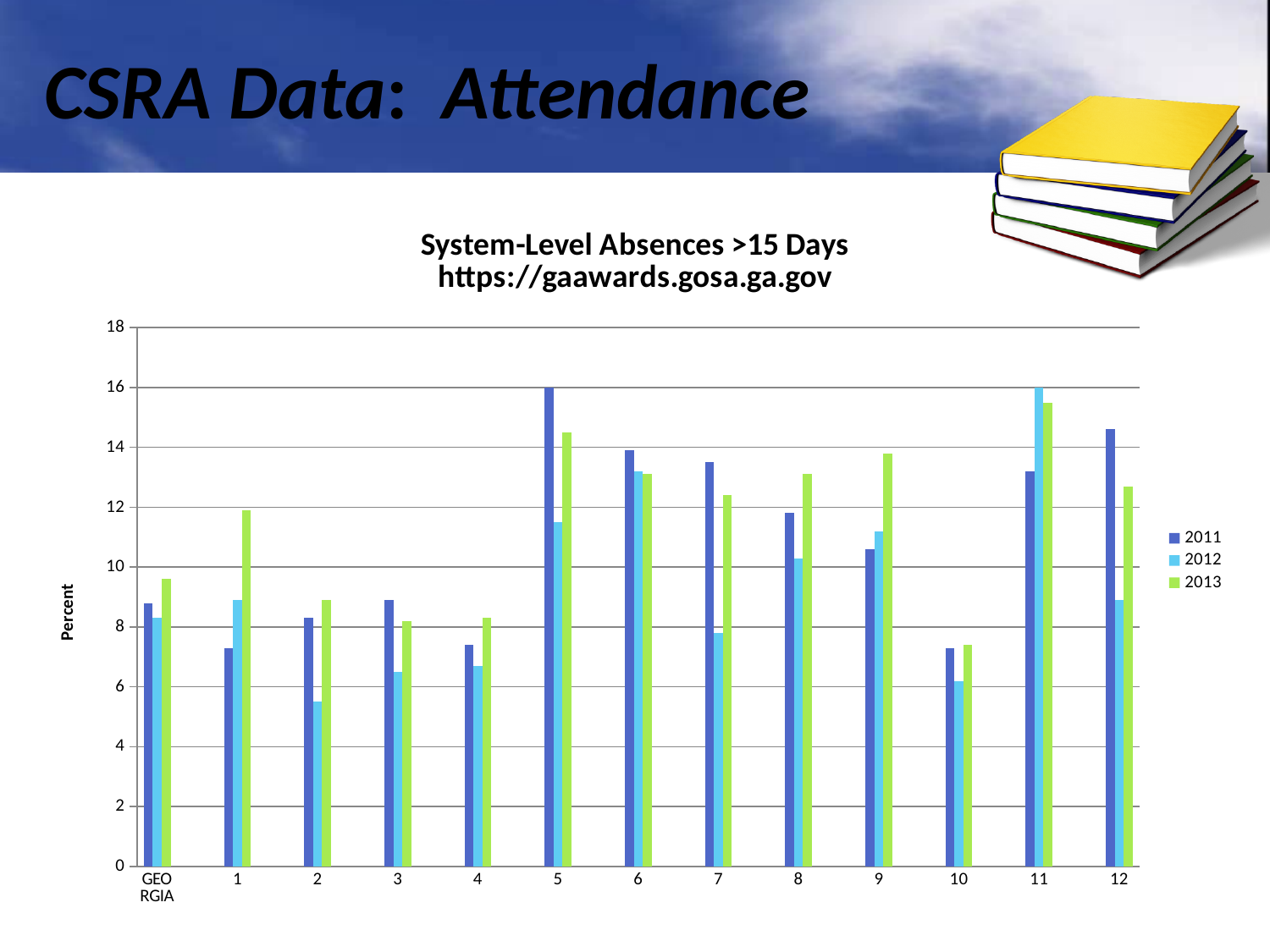
Is the 2012 value for category 2 greater or less than 6? less For category 12, which series has the larger value, 2011 or 2012? 2011 Which category has the lowest value for the 2013 series? 10 What kind of chart is shown on the slide? bar chart Which category has the lowest value for the 2012 series? 2 How many series does the legend list? 3 Is the 2013 value for category 1 greater or less than 10? greater How many categories are shown along the x axis? 13 Which category has the highest value for the 2012 series? 11 Is the 2011 value for category 12 greater or less than 14? greater Which category has the highest value for the 2011 series? 5 What is the label on the y axis? Percent